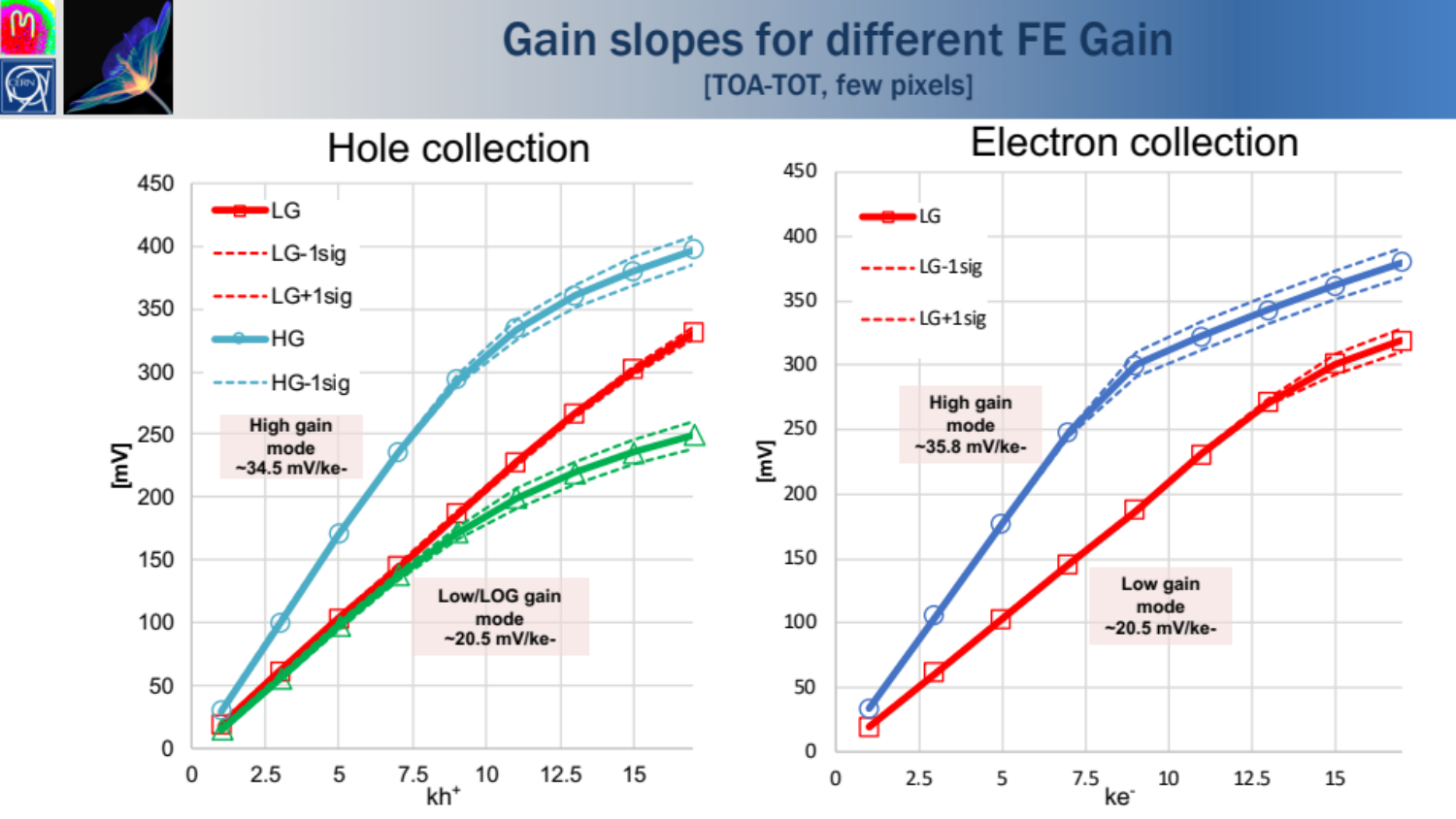
What is the y-axis label on the Electron collection chart? [mV] In the Electron collection chart, which series is higher at 5 ke-, the blue series or LG? the blue series How many marked data points does the LG series have in the Hole collection chart? 9 In the Electron collection chart, do the LG values rise or fall as ke- increases? rise In the Electron collection chart, is the LG value at 9 ke- greater or less than 150? greater In the Electron collection chart, is the blue series value at 17 ke- greater or less than 400? less In the Hole collection chart, is the LG value at 13 kh+ greater or less than 250? greater What kind of chart is the Hole collection chart? line chart In the Hole collection chart, which series is higher at 10 kh+, HG or LG? HG How many series does the legend of the Electron collection chart list? 3 How many series does the legend of the Hole collection chart list? 5